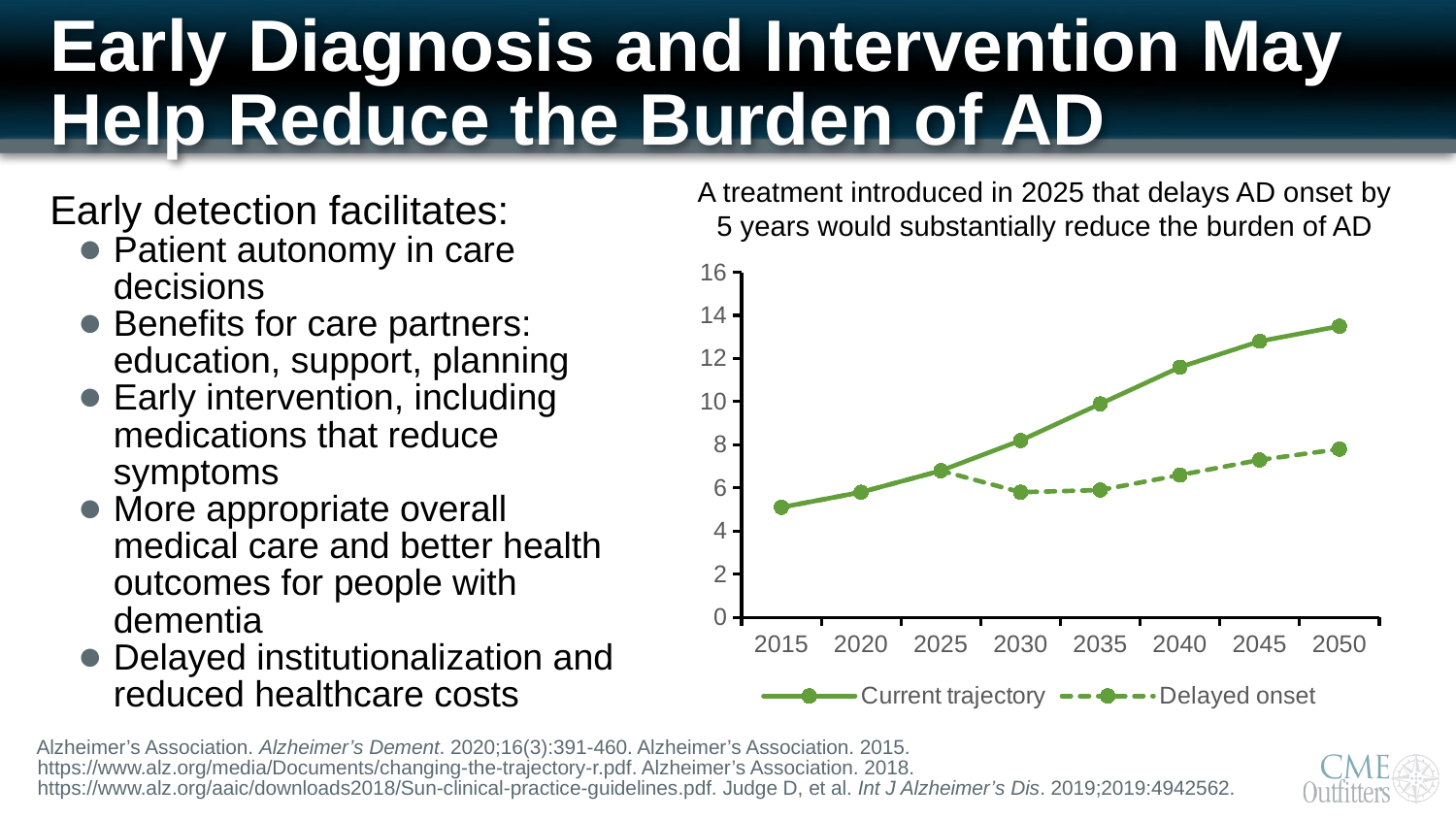
How many series does the chart legend list? 2 Does the Current trajectory series rise or fall from 2015 to 2050? rise In 2050, which series has the larger value, Current trajectory or Delayed onset? Current trajectory In which year is the Current trajectory series at its lowest value? 2015 What kind of chart is shown on the slide? Line chart In which year does the Current trajectory series reach its highest value? 2050 Is the Current trajectory value for 2050 greater or less than 12? greater How many years are marked along the x axis of the chart? 8 Is the Delayed onset value for 2050 greater or less than 10? less Is the Current trajectory value for 2040 greater or less than 10? greater Which series is drawn with a dashed line in the chart? Delayed onset